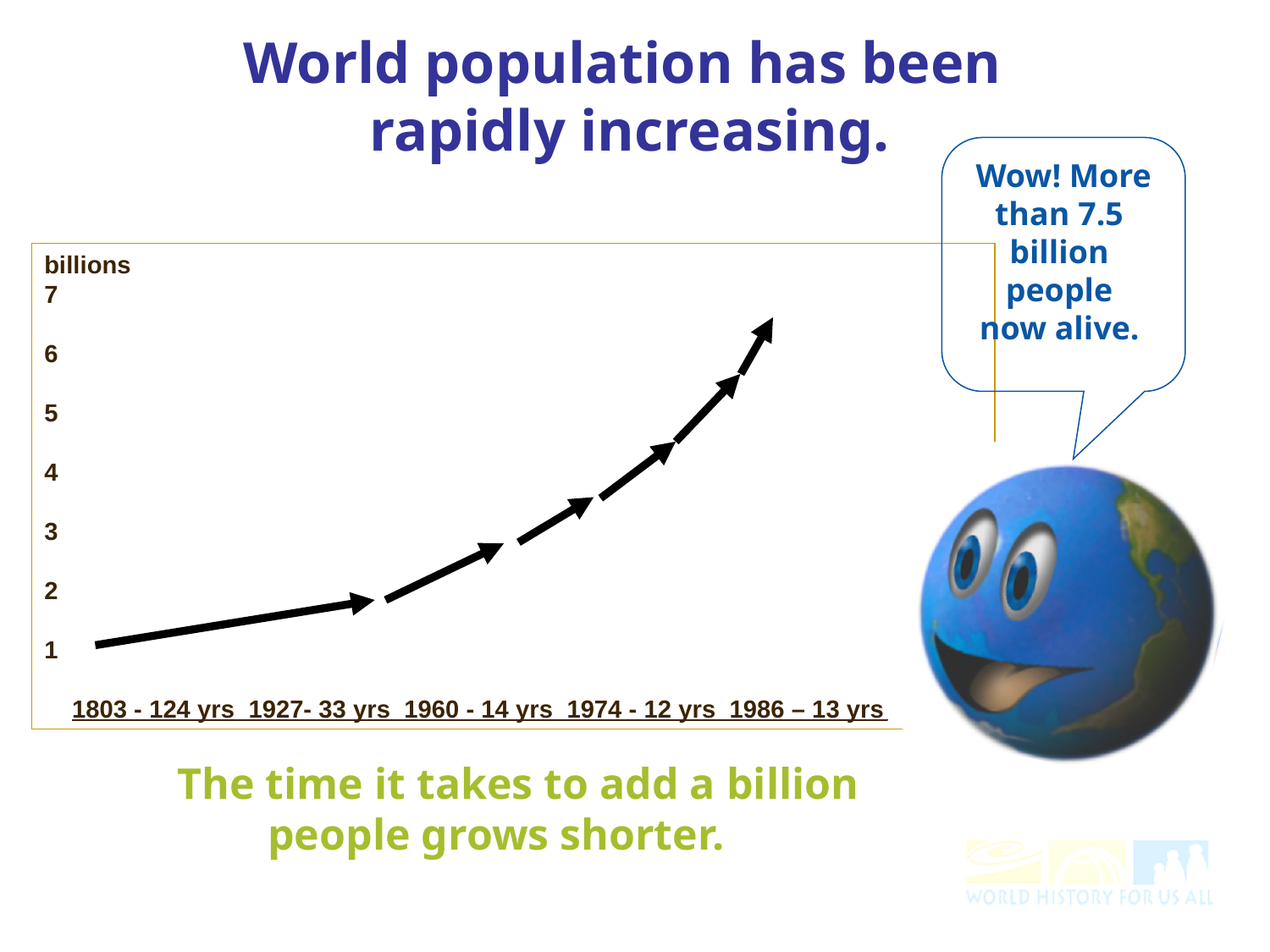
Is the value at the right-hand end of the line greater or less than 5 billion? greater Do the values on the chart rise or fall from left to right along the x axis? rise How many years are shown next to 1927 on the horizontal axis? 33 yrs How many years are shown next to 1960 on the horizontal axis? 14 yrs How many year labels are listed along the chart's horizontal axis? 5 What is the highest value marked on the chart's vertical axis? 7 How many years are shown next to 1974 on the horizontal axis? 12 yrs How many years are shown next to 1803 on the horizontal axis? 124 yrs How many years are shown next to 1986 on the horizontal axis? 13 yrs Is the value at the left-hand start of the line greater or less than 2 billion? less What kind of chart is shown on the slide? line chart What unit is labelled at the top of the chart's vertical axis? billions